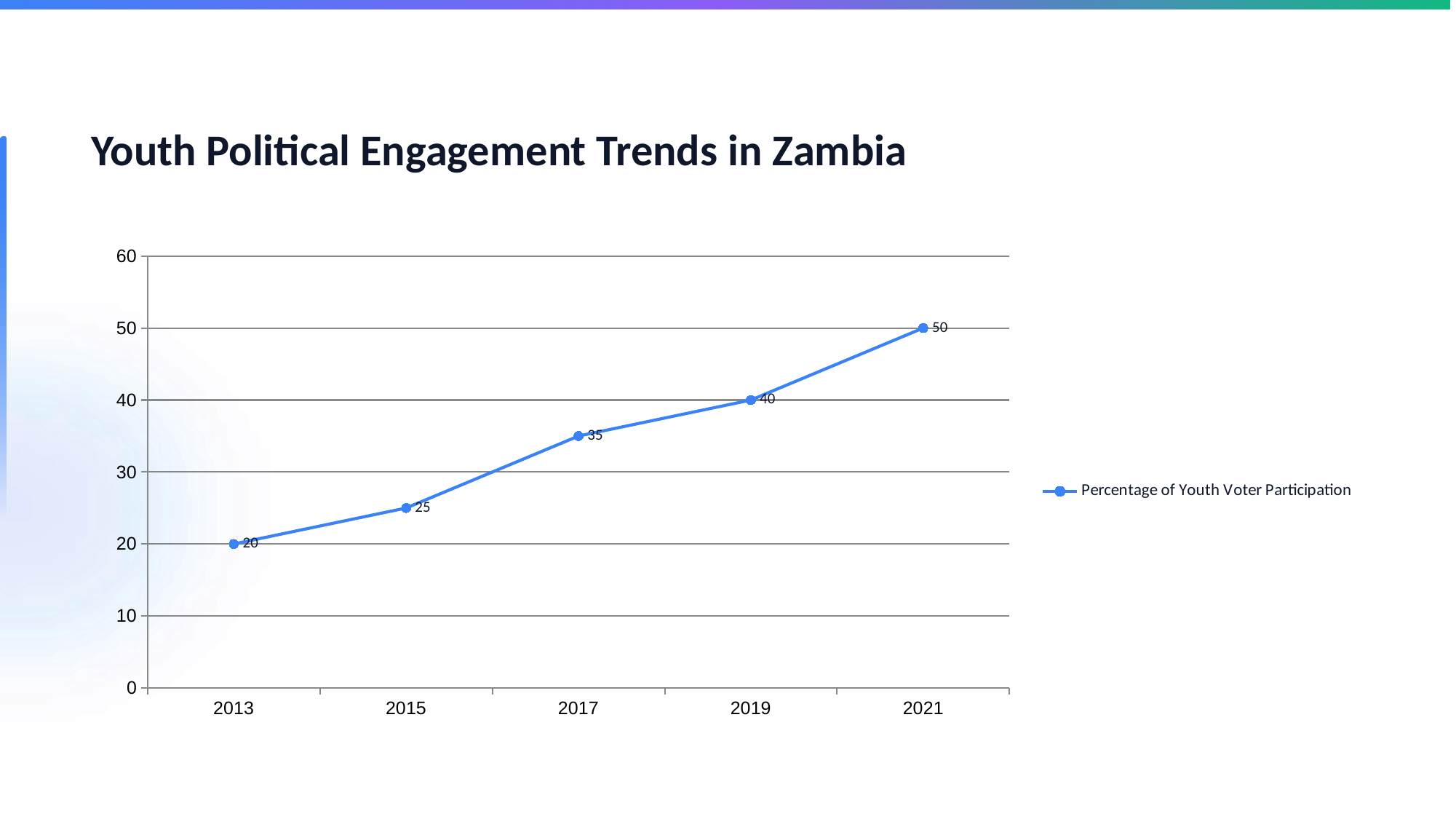
What is the Percentage of Youth Voter Participation in 2013? 20 What is the Percentage of Youth Voter Participation in 2017? 35 Does the Percentage of Youth Voter Participation rise or fall from 2013 to 2021? Rise What is the difference in Percentage of Youth Voter Participation between 2019 and 2015? 15 How many years are plotted on the chart? 5 Which year has the highest Percentage of Youth Voter Participation? 2021 How many series does the legend list? 1 What kind of chart is shown on the slide? Line chart Which year has the lowest Percentage of Youth Voter Participation? 2013 What is the difference in Percentage of Youth Voter Participation between 2021 and 2013? 30 Which year has a higher Percentage of Youth Voter Participation, 2015 or 2019? 2019 What is the Percentage of Youth Voter Participation in 2021? 50